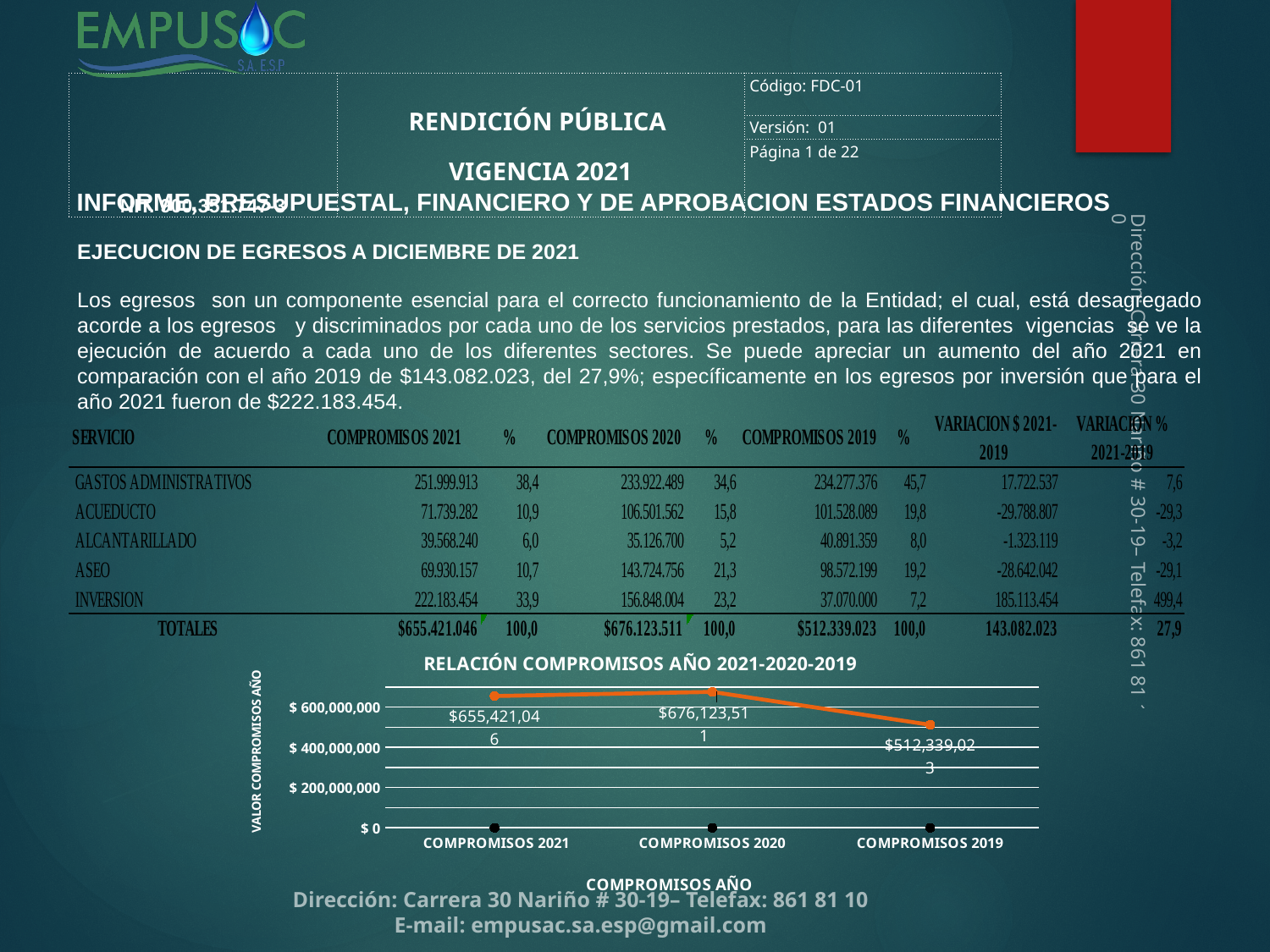
What is the title of the y axis of the chart? VALOR COMPROMISOS AÑO What is the difference between the values for COMPROMISOS 2021 and COMPROMISOS 2019 in the chart? $143,082,023 What is the value plotted for COMPROMISOS 2020 in the chart? $676,123,511 Is the value for COMPROMISOS 2019 greater or less than $600,000,000? less What is the value plotted for COMPROMISOS 2019 in the chart? $512,339,023 Which category has the lowest value in the chart? COMPROMISOS 2019 What is the value plotted for COMPROMISOS 2021 in the chart? $655,421,046 Which is larger in the chart, the value for COMPROMISOS 2021 or COMPROMISOS 2019? COMPROMISOS 2021 What type of chart is shown under the title 'RELACIÓN COMPROMISOS AÑO 2021-2020-2019'? Line chart What is the difference between the values for COMPROMISOS 2020 and COMPROMISOS 2021 in the chart? $20,702,465 Which category has the highest value in the chart? COMPROMISOS 2020 How many categories are plotted along the x axis of the chart? 3